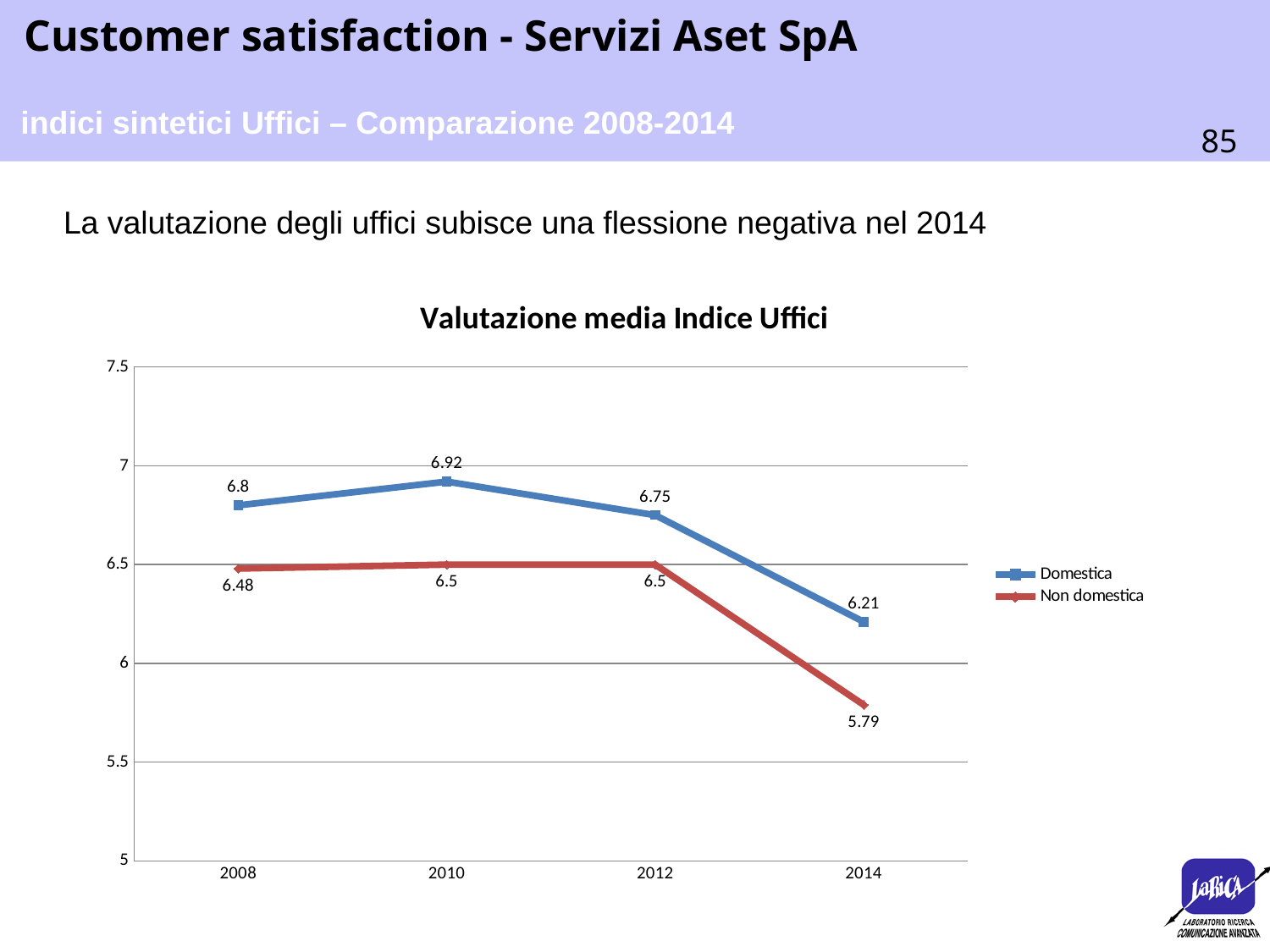
What is the difference between Domestica and Non domestica in 2014? 0.42 How many years are shown on the x axis? 4 What is the value for Non domestica in 2014? 5.79 What is the value for Domestica in 2014? 6.21 What is the value for Non domestica in 2008? 6.48 How many series does the legend list? 2 In which year is the Non domestica series lowest? 2014 What kind of chart is shown? line chart Is the value for Non domestica in 2014 greater or less than 6? less Which series has the higher value in 2012, Domestica or Non domestica? Domestica In which year is the Domestica series highest? 2010 What is the value for Domestica in 2010? 6.92